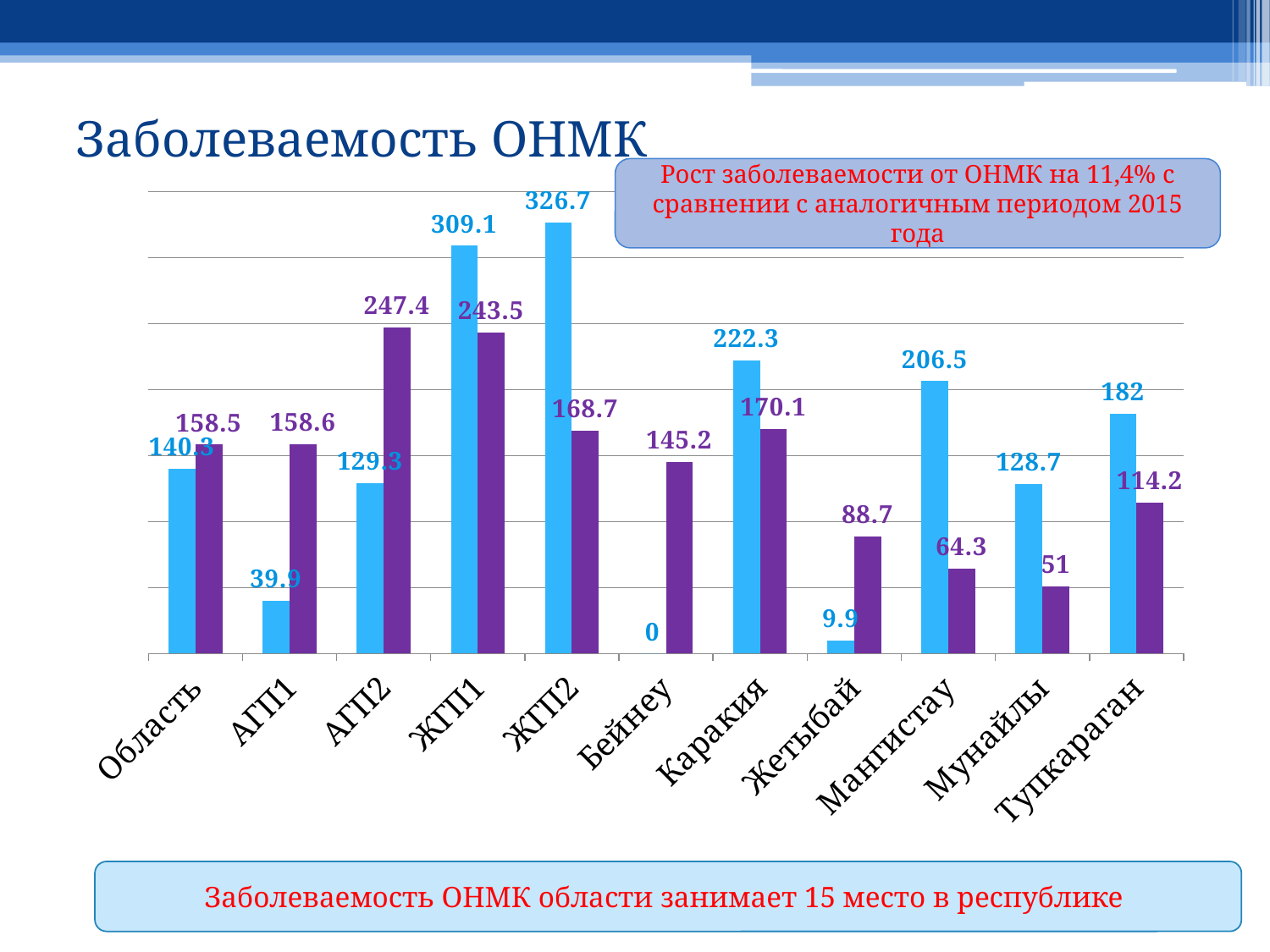
What is the difference between the blue and purple bars for ЖГП1? 65.6 What type of chart is shown on the slide? bar chart What is the value of the blue bar for ЖГП2? 326.7 What is the value of the purple bar for АГП2? 247.4 Which category has the highest blue bar? ЖГП2 What is the difference between the blue and purple bars for Мангистау? 142.2 What is the value of the purple bar for Мунайлы? 51 For Каракия, which bar is larger, the blue or the purple one? blue Which category has the lowest blue bar? Бейнеу How many categories are shown on the x axis? 11 Which category has the lowest purple bar? Мунайлы What is the value of the blue bar for Жетыбай? 9.9